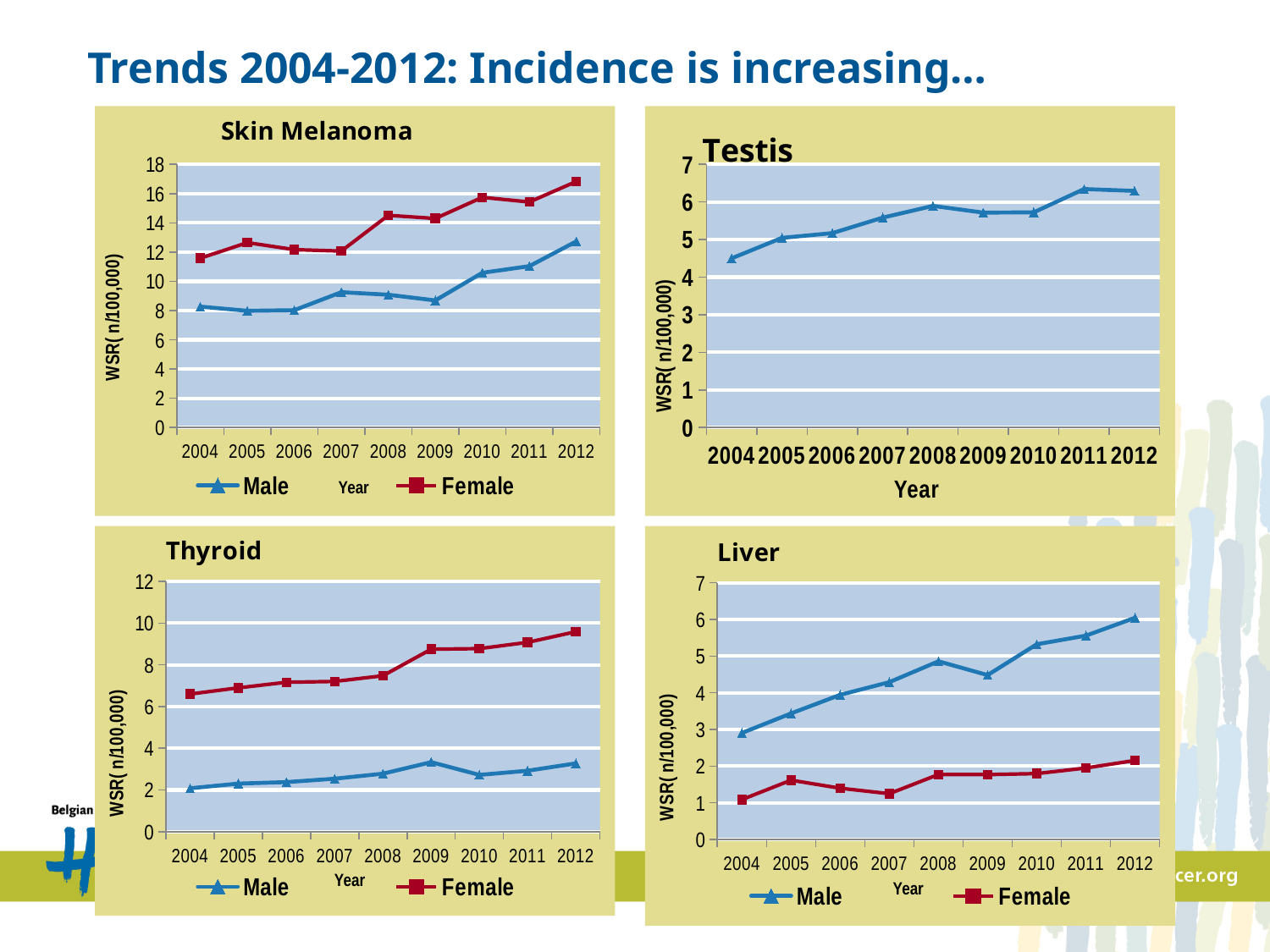
In the Skin Melanoma chart, is the Female value for 2004 greater or less than 12? less In the Testis chart, is the value for 2004 greater or less than 5? less In the Thyroid chart, which series is larger in 2012, Male or Female? Female In the Liver chart, does the Male series generally rise or fall from 2004 to 2012? rise In the Skin Melanoma chart, which year has the highest Female value? 2012 What kind of chart is the Skin Melanoma chart? line chart In the Testis chart, which year has the lowest value? 2004 In the Thyroid chart, is the Female value for 2012 greater or less than 10? less How many years are plotted on the x axis of the Testis chart? 9 In the Liver chart, which year has the highest Male value? 2012 How many series does the legend of the Skin Melanoma chart list? 2